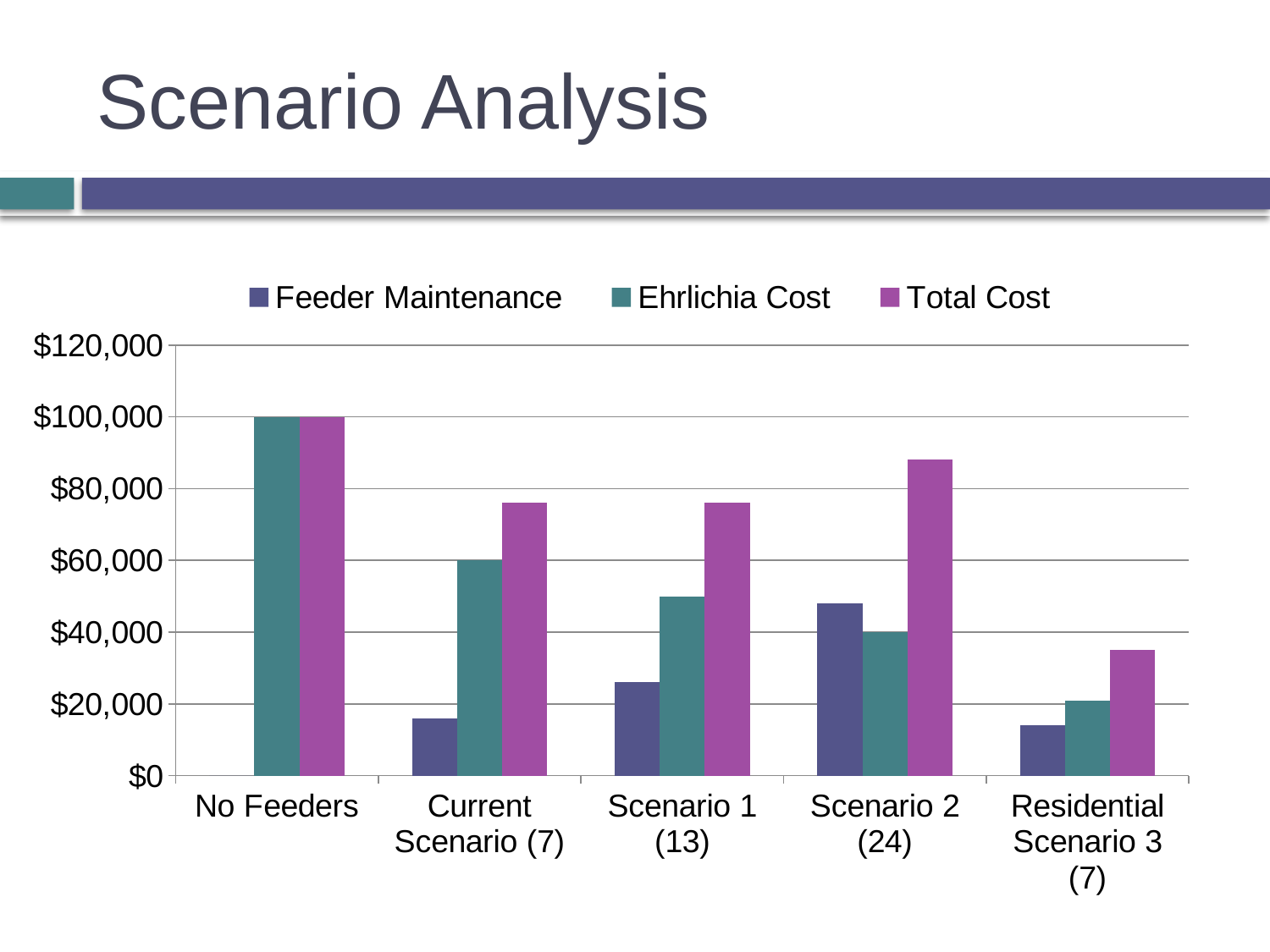
What is the Ehrlichia Cost for the Current Scenario (7)? $60,000 Which category has the highest Total Cost? No Feeders Which category has the highest Feeder Maintenance cost? Scenario 2 (24) What type of chart is shown on the slide? bar chart Which category has the lowest Total Cost? Residential Scenario 3 (7) For Scenario 2 (24), which is larger: Feeder Maintenance or Ehrlichia Cost? Feeder Maintenance What is the Total Cost for No Feeders? $100,000 What is the Ehrlichia Cost for Scenario 2 (24)? $40,000 Is the Total Cost for Residential Scenario 3 (7) greater or less than $40,000? less How many scenario categories are shown on the x axis? 5 Is the Total Cost for Scenario 2 (24) greater or less than $80,000? greater How many series does the legend list? 3